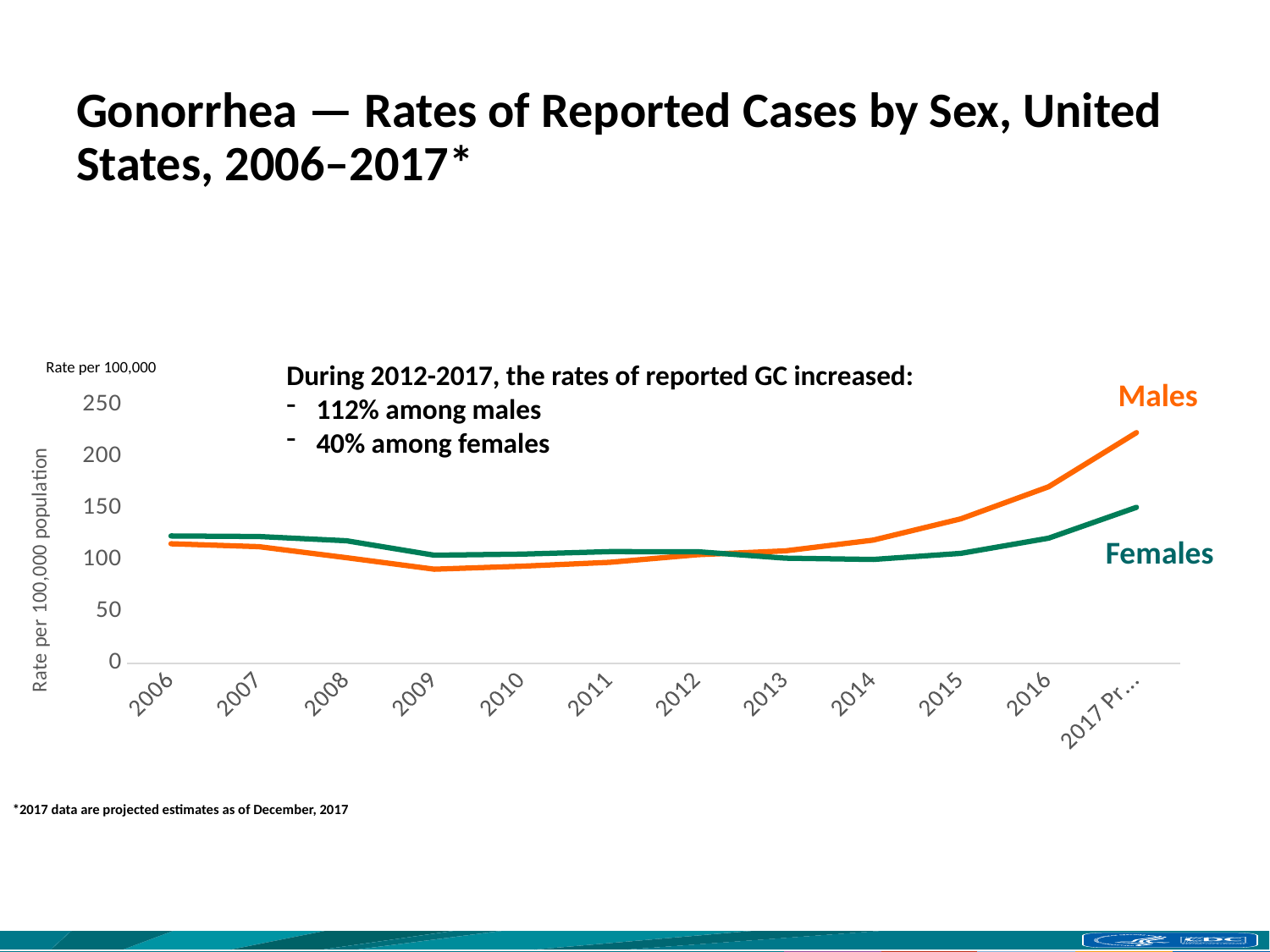
How many series are plotted on the chart? 2 Is the value for Males in 2016 greater or less than 150? greater How many years (points) are shown along the x axis of the chart? 12 What colour is the Males line on the chart? orange Do the values for Males rise or fall from 2012 to 2017? rise Is the value for Males in 2017 greater or less than 200? greater What kind of chart is shown on the slide? line chart Which series has the higher value in 2009, Males or Females? Females Which series has the higher value in 2017, Males or Females? Males According to the text on the chart, by what percentage did rates among males increase during 2012-2017? 112% Is the value for Females in 2017 greater or less than 100? greater